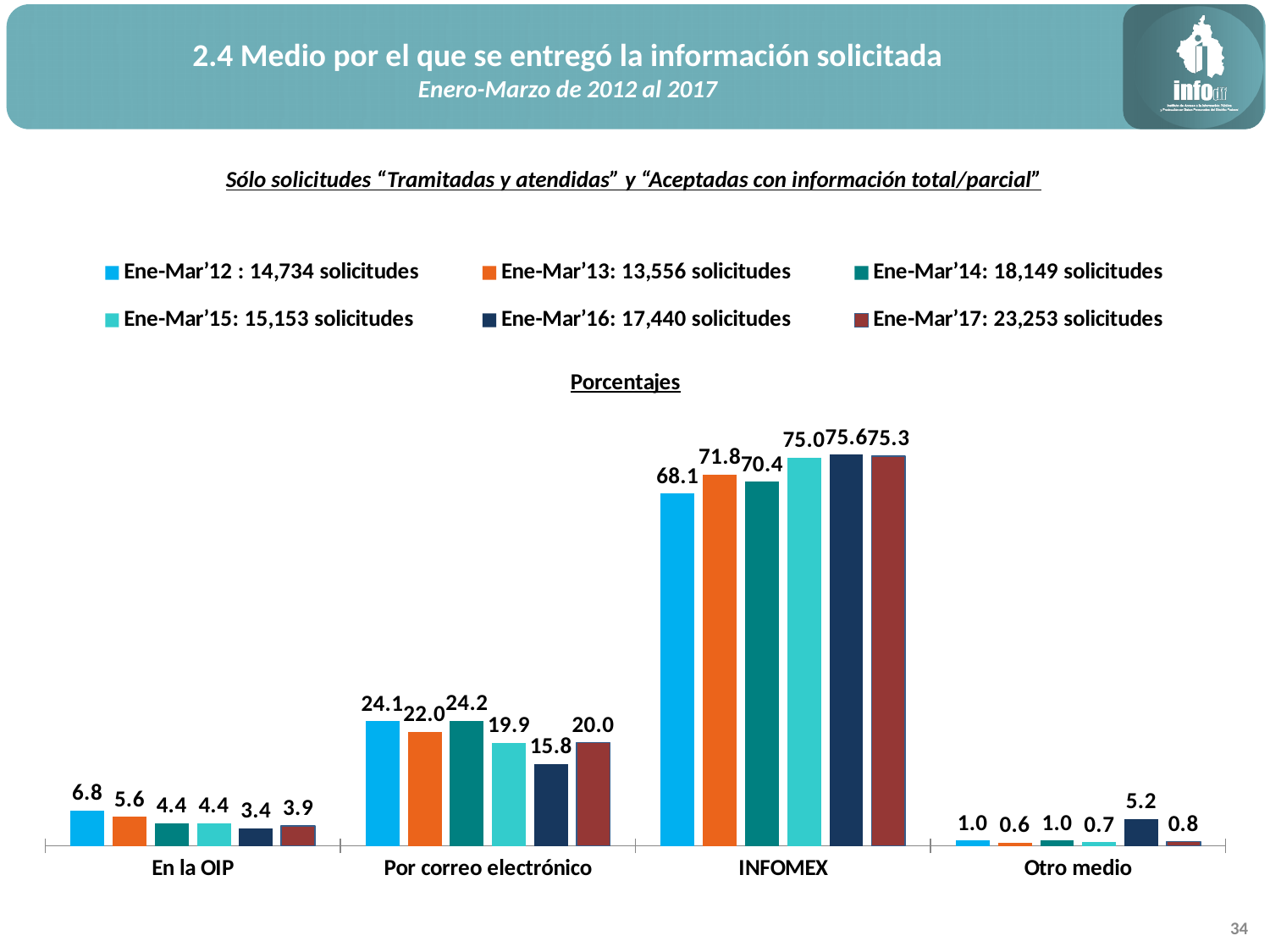
How many series does the legend list? 6 What type of chart is shown on the slide? Bar chart What is the value for Otro medio in the Ene-Mar'16 series? 5.2 Which series has the lowest value for En la OIP? Ene-Mar'16 How many solicitudes does the legend give for Ene-Mar'17? 23,253 solicitudes Which is larger for Por correo electrónico: the Ene-Mar'12 value or the Ene-Mar'13 value? Ene-Mar'12 What is the value for INFOMEX in the Ene-Mar'12 series? 68.1 What is the difference between the Ene-Mar'16 and Ene-Mar'12 values for INFOMEX? 7.5 How many categories are shown on the x axis? 4 What is the value for Por correo electrónico in the Ene-Mar'16 series? 15.8 Which category has the highest value in the Ene-Mar'17 series? INFOMEX Do the values for En la OIP generally rise or fall from Ene-Mar'12 to Ene-Mar'17? Fall